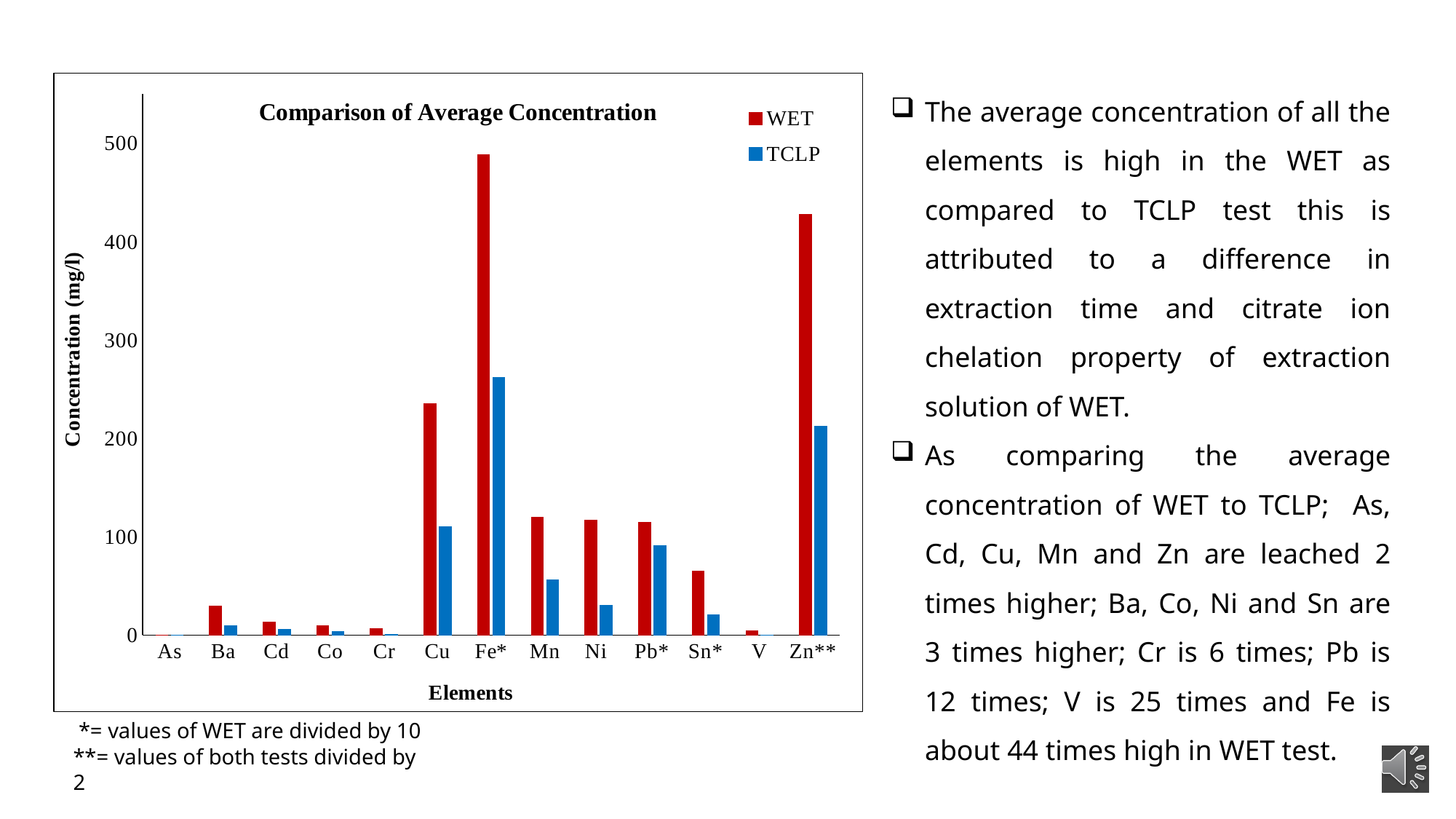
Which element has the highest TCLP concentration? Fe* Is the WET value for Sn* greater or less than 100? less How many elements are shown on the x axis? 13 Which is larger, the WET value for Fe* or the WET value for Zn**? Fe* What is the title of the chart? Comparison of Average Concentration How many series does the legend list? 2 Is the WET value for Cu greater or less than 200? greater Is the TCLP value for Fe* greater or less than 200? greater Which element has the highest WET concentration? Fe* What kind of chart is shown on the slide? bar chart Which is larger, the TCLP value for Pb* or the TCLP value for Ni? Pb*